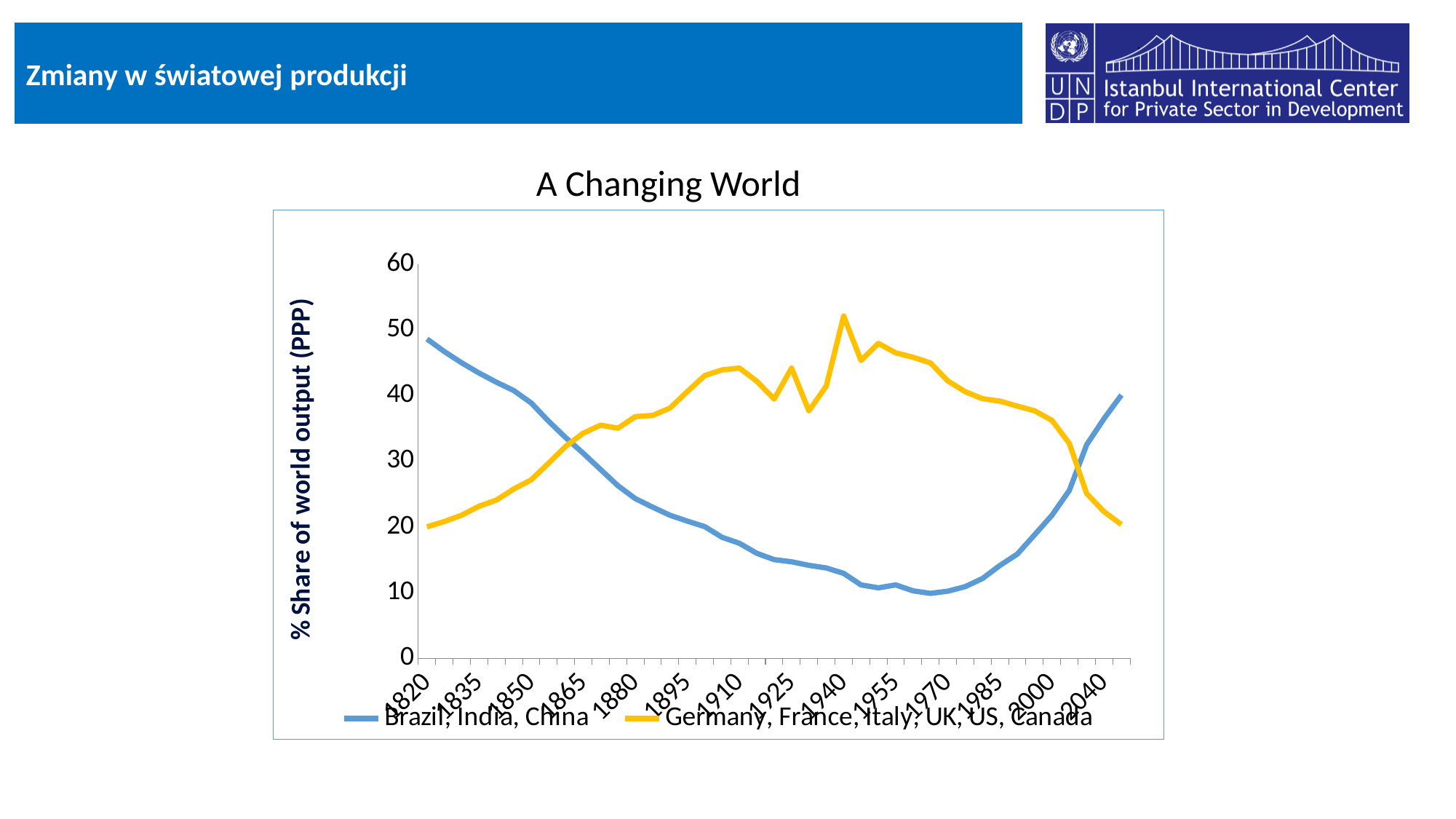
In 1820, which series has the higher share of world output? Brazil, India, China Is the value for Germany, France, Italy, UK, US, Canada in 1970 greater or less than 40? greater Does the Brazil, India, China line rise or fall between 1820 and 1970? fall Does the Germany, France, Italy, UK, US, Canada line rise or fall between 1820 and 1910? rise Is the value for Brazil, India, China in 1820 greater or less than 40? greater In 1910, which series has the higher share of world output? Germany, France, Italy, UK, US, Canada Is the value for Brazil, India, China in 1970 greater or less than 20? less What is the label on the vertical axis? % Share of world output (PPP) What kind of chart is shown on the slide? line chart How many series does the legend list? 2 What is the title of the chart? A Changing World